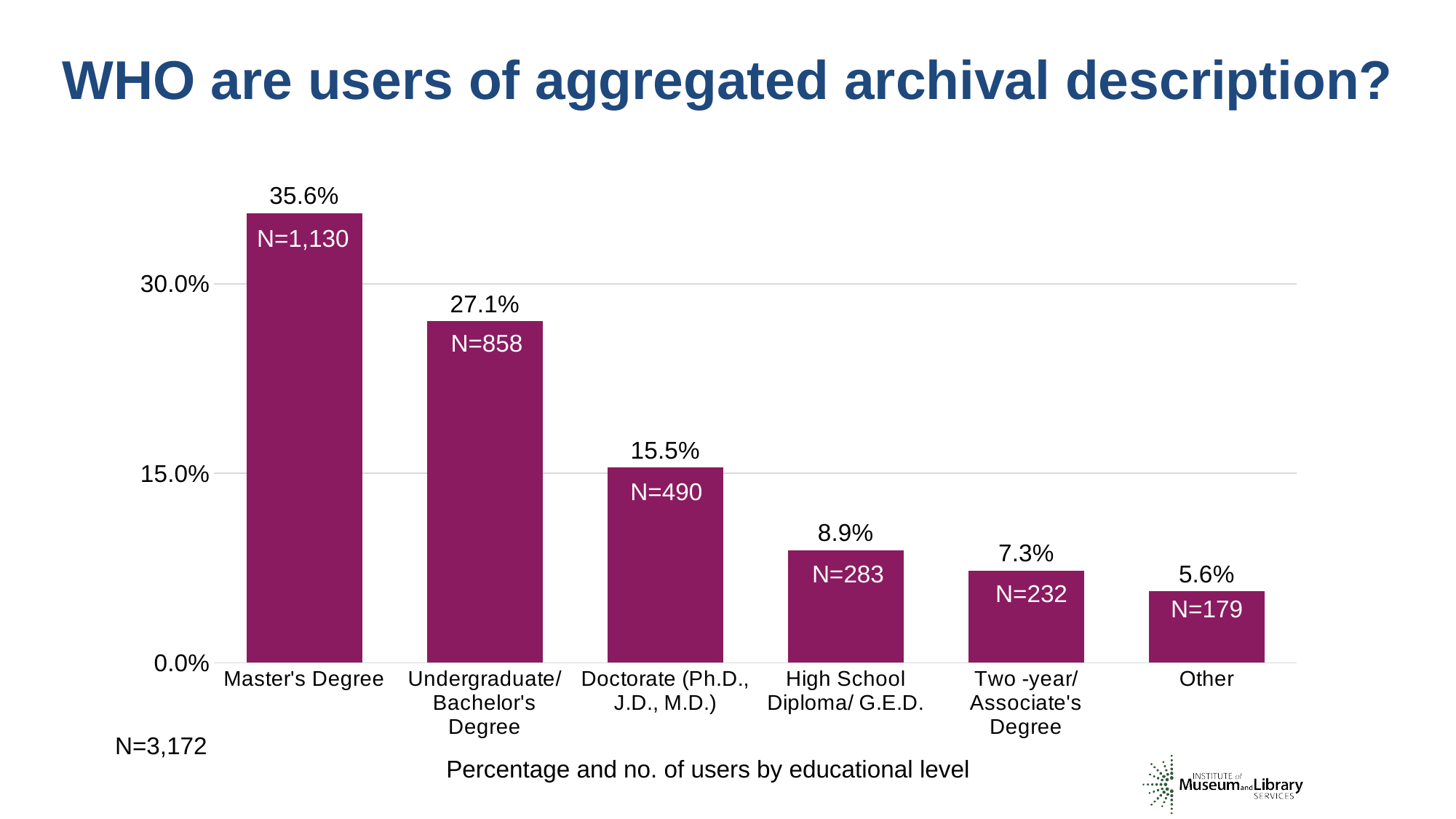
Do the values rise or fall moving from left to right along the x axis? Fall What is the difference in percentage between Master's Degree and Undergraduate/Bachelor's Degree users? 8.5% What percentage of users fall in the Other category? 5.6% What type of chart is shown on the slide? Bar chart How many educational level categories are shown in the chart? 6 What percentage of users have a Master's Degree? 35.6% Which educational level has the highest percentage of users? Master's Degree What is the total N reported for the chart? N=3,172 Which educational level has the lowest percentage of users? Other What is the number of users (N) with a Doctorate (Ph.D., J.D., M.D.)? N=490 Is the value for Undergraduate/Bachelor's Degree greater or less than 30.0%? less Which has a larger share of users: High School Diploma/G.E.D. or Two-year/Associate's Degree? High School Diploma/ G.E.D.